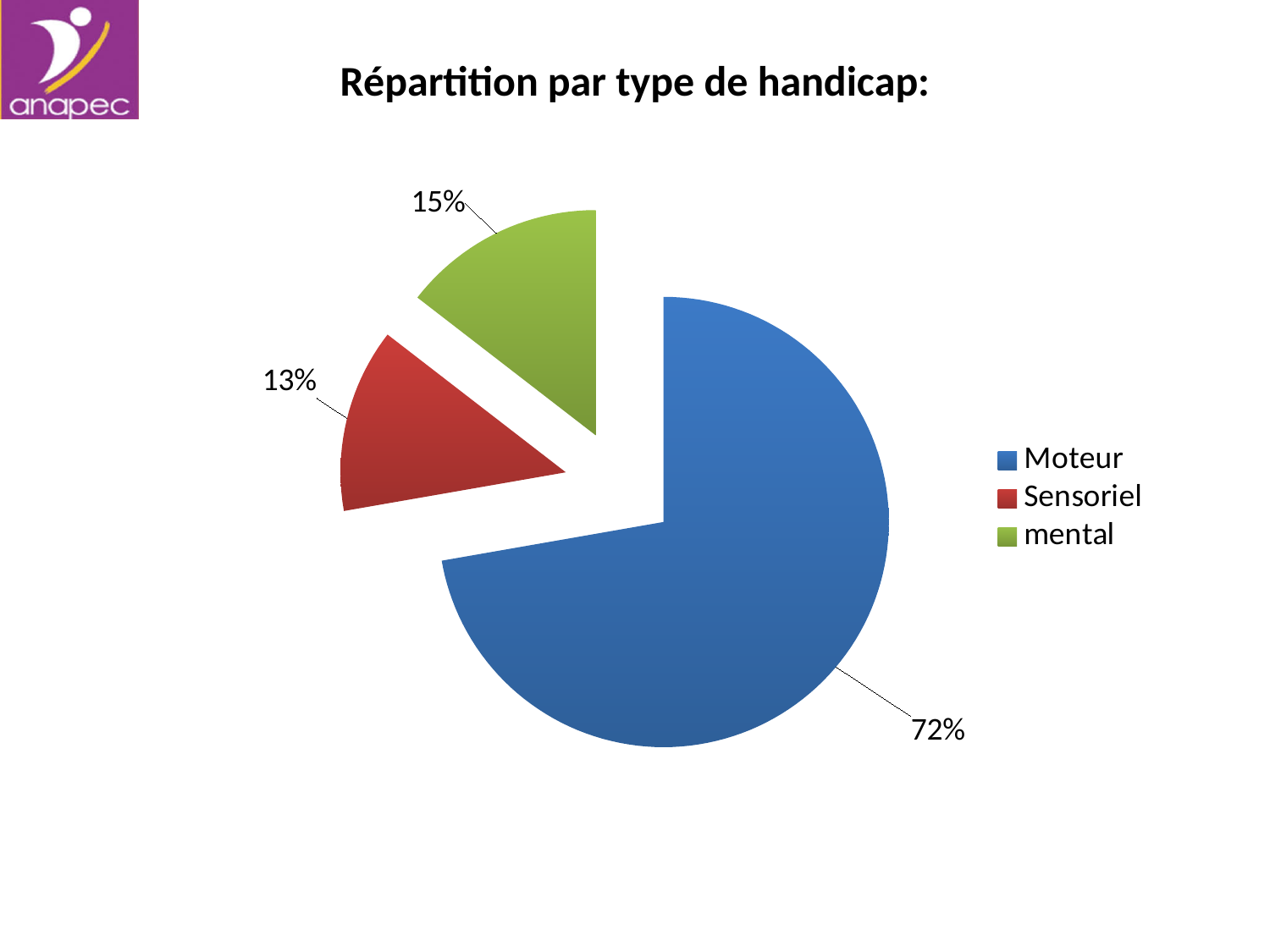
What is the difference in percentage points between Moteur and mental? 57 What share of the pie does Moteur represent? 72% How many categories does the pie chart show? 3 What share of the pie does Sensoriel represent? 13% Which type of handicap has the largest share? Moteur Which is larger, the share for Sensoriel or the share for mental? mental What is the difference in percentage points between mental and Sensoriel? 2 Which type of handicap has the smallest share? Sensoriel What is the title of the chart? Répartition par type de handicap: What colour is the Sensoriel slice? red What share of the pie does mental represent? 15% What kind of chart is shown on the slide? pie chart